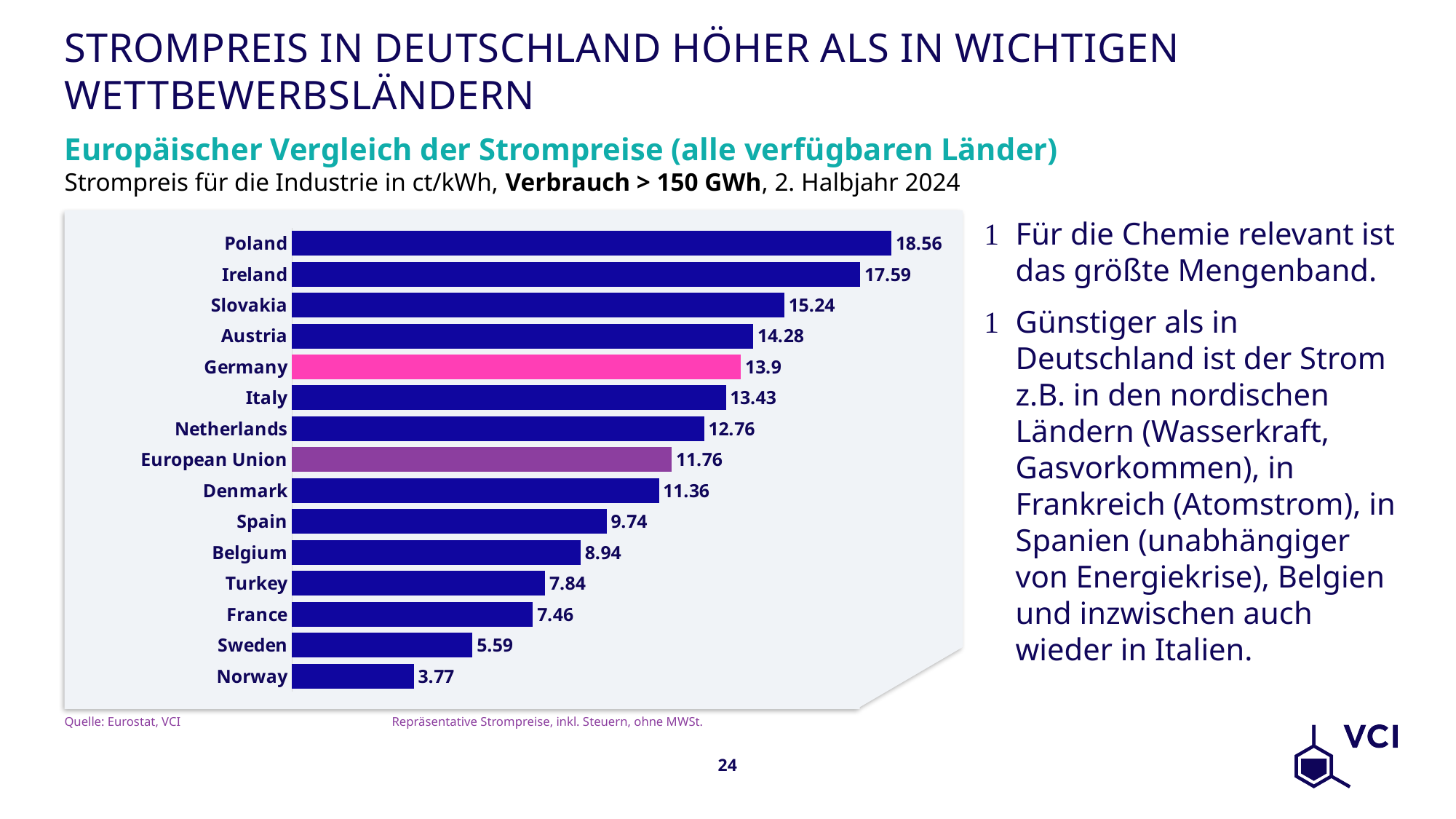
Which country has the lowest electricity price in the chart? Norway Which has a higher value, Austria or Italy? Austria What is the value shown for the European Union? 11.76 What kind of chart is shown on the slide? Bar chart Which bar in the chart is highlighted in pink? Germany What is the difference between the values for Germany and France? 6.44 What is the value shown for Norway? 3.77 What is the electricity price shown for Germany? 13.9 Which country has the highest electricity price in the chart? Poland What is the difference between the values for Poland and Germany? 4.66 Which has a higher value, Sweden or Turkey? Turkey How many countries or regions are shown in the chart? 15